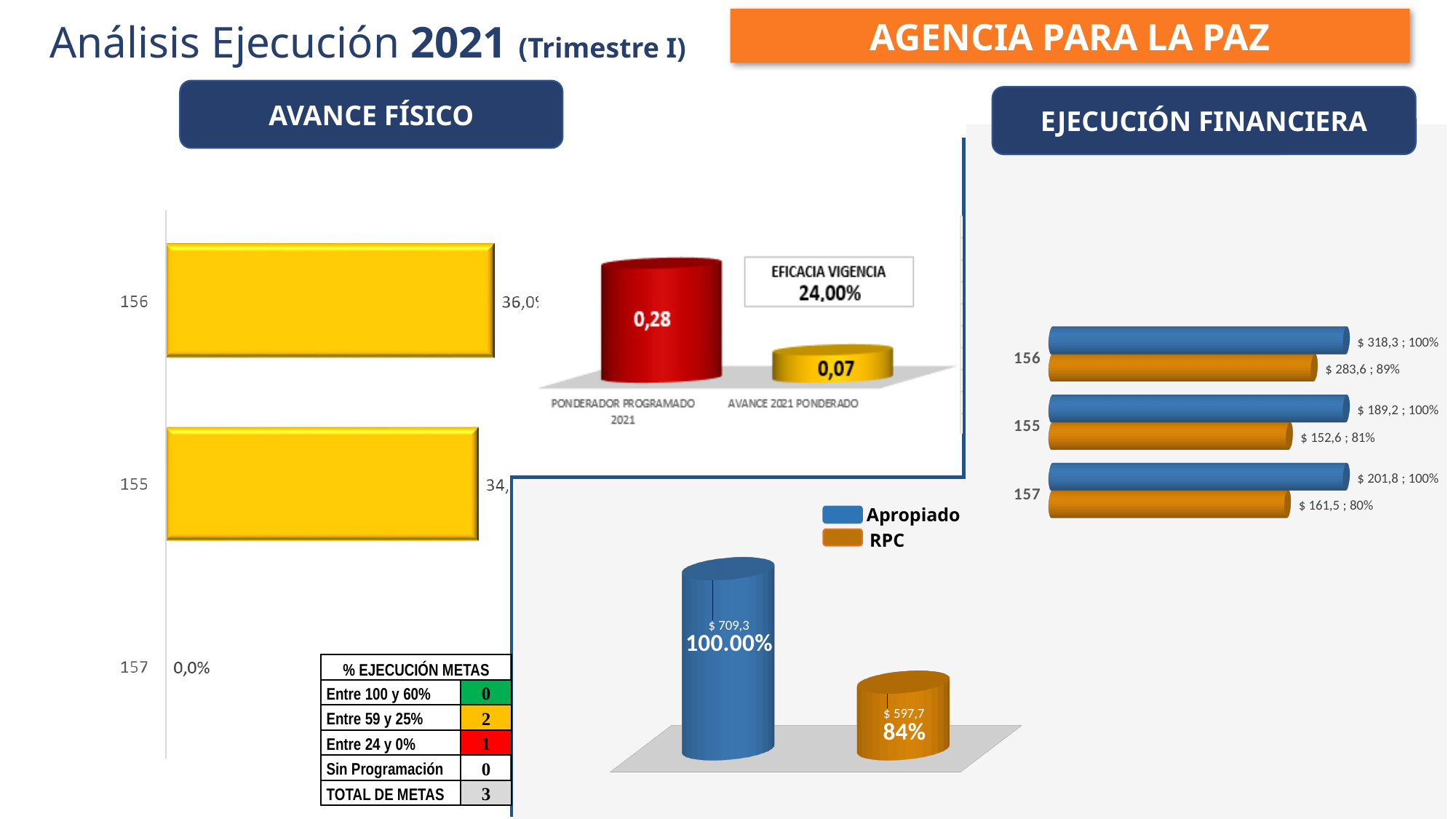
In the Ejecución Financiera bar chart on the right, what percentage is shown next to the RPC bar for category 157? 80% In the Avance Físico bar chart on the left, what is the value for category 157? 0,0% In the Ejecución Financiera bar chart on the right, what is the difference between the Apropiado and RPC values for category 156? $ 34,7 In the Ejecución Financiera bar chart on the right, how many series does the legend list? 2 In the cylinder chart at the top centre, which is larger: Ponderador Programado 2021 or Avance 2021 Ponderado? Ponderador Programado 2021 In the Ejecución Financiera bar chart on the right, which category has the highest Apropiado value? 156 In the Ejecución Financiera bar chart on the right, which category has the lowest RPC value? 155 In the cylinder chart at the bottom centre, what percentage is shown on the RPC cylinder? 84% In the cylinder chart at the bottom centre, what is the value of the Apropiado cylinder? $ 709,3 In the Ejecución Financiera bar chart on the right, what is the Apropiado value for category 156? $ 318,3 In the Ejecución Financiera bar chart on the right, what is the RPC value for category 155? $ 152,6 In the cylinder chart at the top centre, what is the value for Ponderador Programado 2021? 0,28